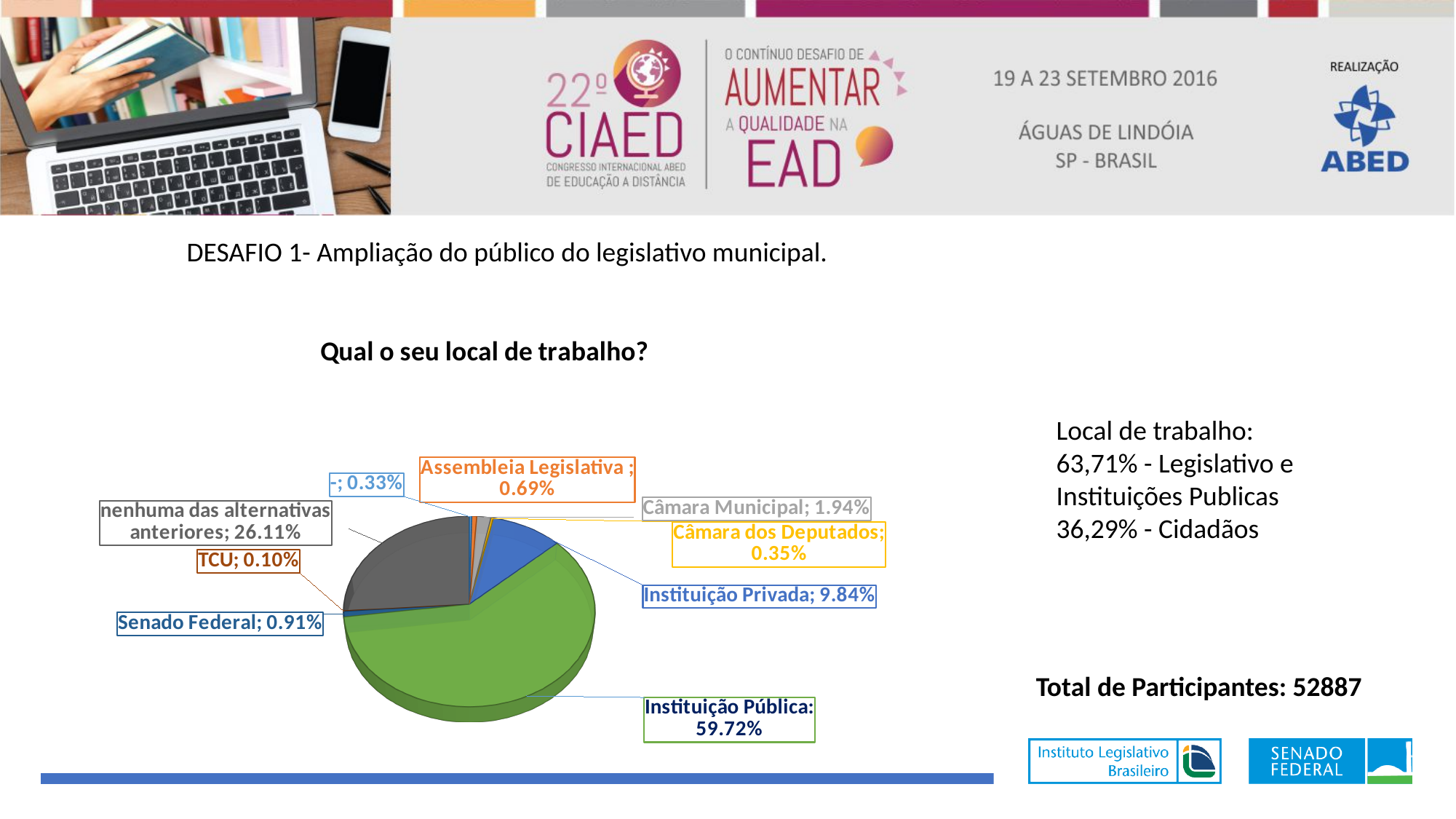
What kind of chart is shown on the slide? pie chart Which category has the largest slice of the pie? Instituição Pública What is the value for Câmara Municipal? 1.94% What is the value for Instituição Privada? 9.84% What is the value for nenhuma das alternativas anteriores? 26.11% Which category has the smallest slice of the pie? TCU What share of the pie does Instituição Pública have? 59.72% What is the chart's title? Qual o seu local de trabalho? Which is larger, the value for Senado Federal or the value for Assembleia Legislativa? Senado Federal What is the value for TCU? 0.10% What is the difference between the values for Instituição Pública and nenhuma das alternativas anteriores? 33.61% How many categories are shown in the pie chart? 9